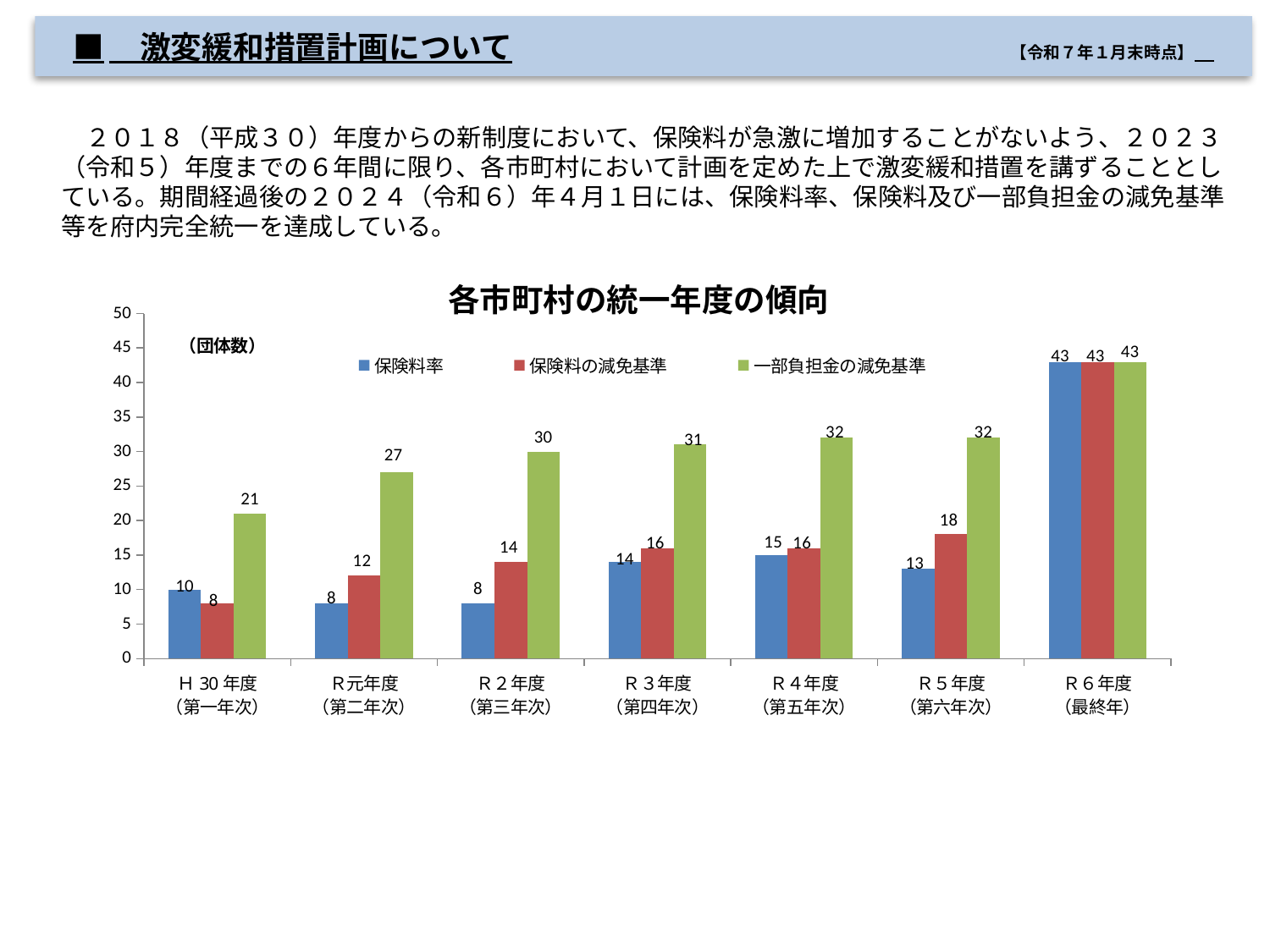
What is the title of the chart? 各市町村の統一年度の傾向 What is the value for 保険料率 in R４年度（第五年次）? 15 What is the difference between 一部負担金の減免基準 and 保険料率 in R２年度（第三年次）? 22 How many fiscal-year categories are shown on the x axis? 7 Which year has the highest value for 保険料率? R６年度（最終年） Which year has the lowest value for 保険料の減免基準? H30年度（第一年次） In H30年度（第一年次）, which is larger: 保険料率 or 保険料の減免基準? 保険料率 What kind of chart is shown on the slide? Bar chart Does the value for 一部負担金の減免基準 rise or fall from H30年度 to R６年度? Rise What is the value for 一部負担金の減免基準 in R元年度（第二年次）? 27 What is the value for 保険料の減免基準 in R５年度（第六年次）? 18 How many series does the legend list? 3